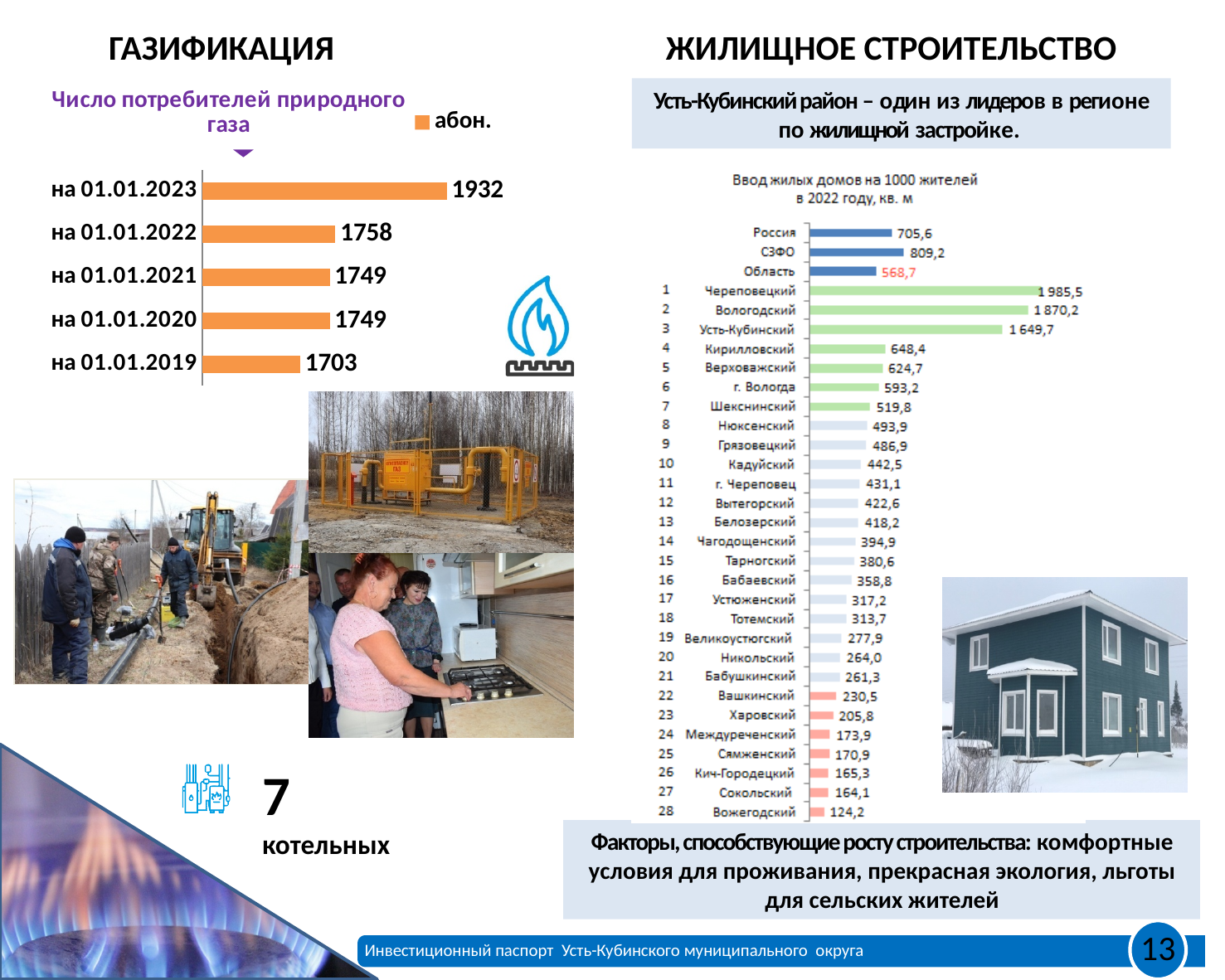
On the chart 'Число потребителей природного газа', what is the value for на 01.01.2019? 1703 On the chart 'Число потребителей природного газа', what is the value for на 01.01.2023? 1932 On the chart 'Число потребителей природного газа', what is the legend entry? абон. On the chart 'Число потребителей природного газа', how many dates are shown? 5 On the chart 'Ввод жилых домов на 1000 жителей в 2022 году, кв. м', which district has the lowest value? Вожегодский On the chart 'Ввод жилых домов на 1000 жителей в 2022 году, кв. м', what is the value for Усть-Кубинский? 1 649,7 On the chart 'Ввод жилых домов на 1000 жителей в 2022 году, кв. м', which district has the highest value? Череповецкий On the chart 'Число потребителей природного газа', what kind of chart is it? bar chart On the chart 'Число потребителей природного газа', which date has the highest value? на 01.01.2023 On the chart 'Ввод жилых домов на 1000 жителей в 2022 году, кв. м', which is larger, the value for СЗФО or the value for Область? СЗФО On the chart 'Число потребителей природного газа', what is the difference between the values for на 01.01.2023 and на 01.01.2022? 174 On the chart 'Ввод жилых домов на 1000 жителей в 2022 году, кв. м', what is the value for Россия? 705,6